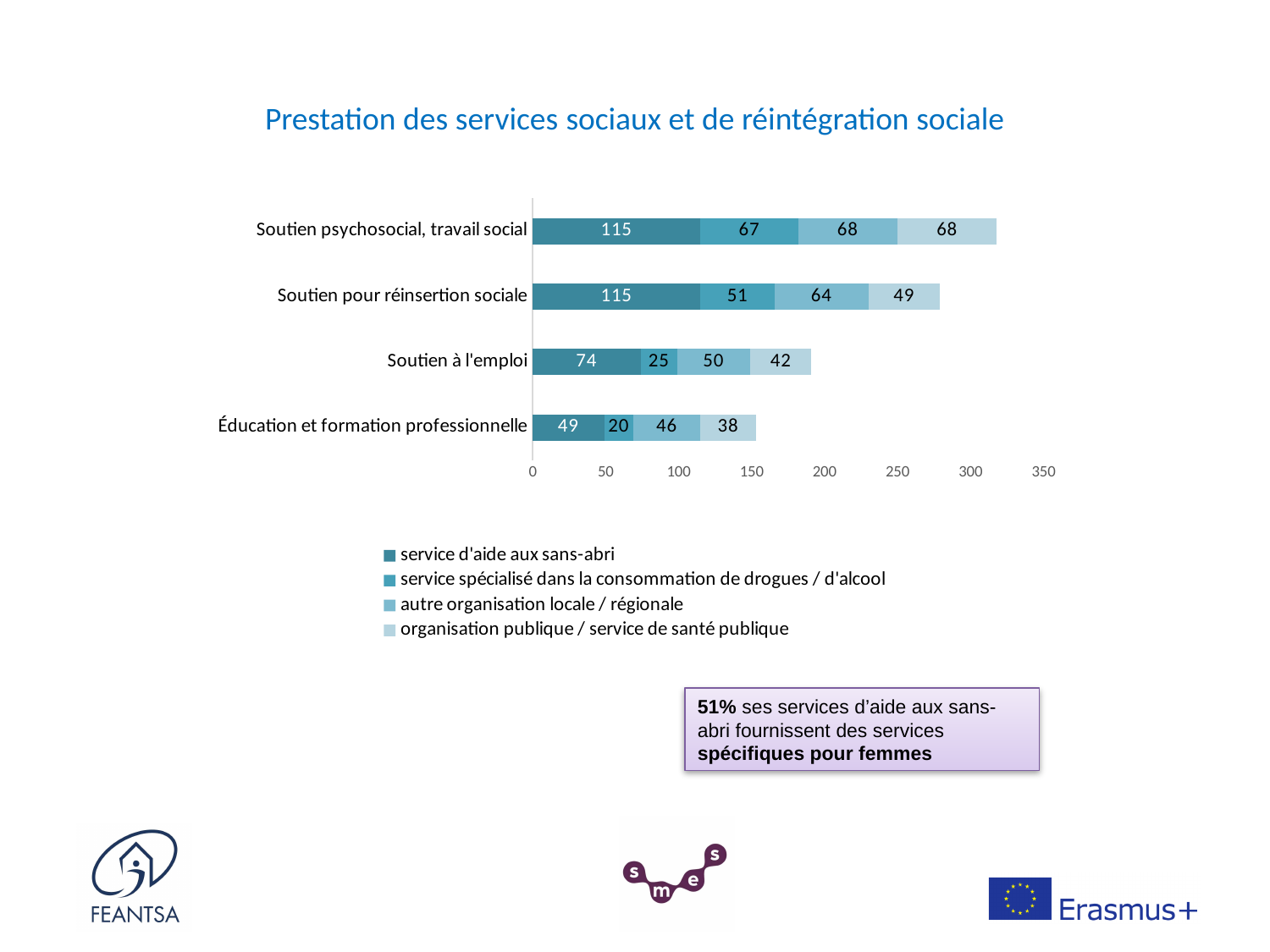
How many series does the legend list? 4 Which is larger: the 'autre organisation locale / régionale' value for 'Soutien pour réinsertion sociale' or for 'Soutien à l'emploi'? Soutien pour réinsertion sociale Which category has the lowest value for 'service spécialisé dans la consommation de drogues / d'alcool'? Éducation et formation professionnelle What is the value for 'organisation publique / service de santé publique' in the 'Soutien pour réinsertion sociale' category? 49 How many categories are shown on the chart? 4 What is the title of the chart? Prestation des services sociaux et de réintégration sociale What is the value for 'autre organisation locale / régionale' in the 'Éducation et formation professionnelle' category? 46 What is the value for 'service d'aide aux sans-abri' in the 'Soutien à l'emploi' category? 74 Which category has the highest total across all series? Soutien psychosocial, travail social What is the total of the stacked bar for 'Soutien à l'emploi'? 191 What kind of chart is shown on the slide? Stacked bar chart What is the difference between the 'service d'aide aux sans-abri' values for 'Soutien psychosocial, travail social' and 'Éducation et formation professionnelle'? 66